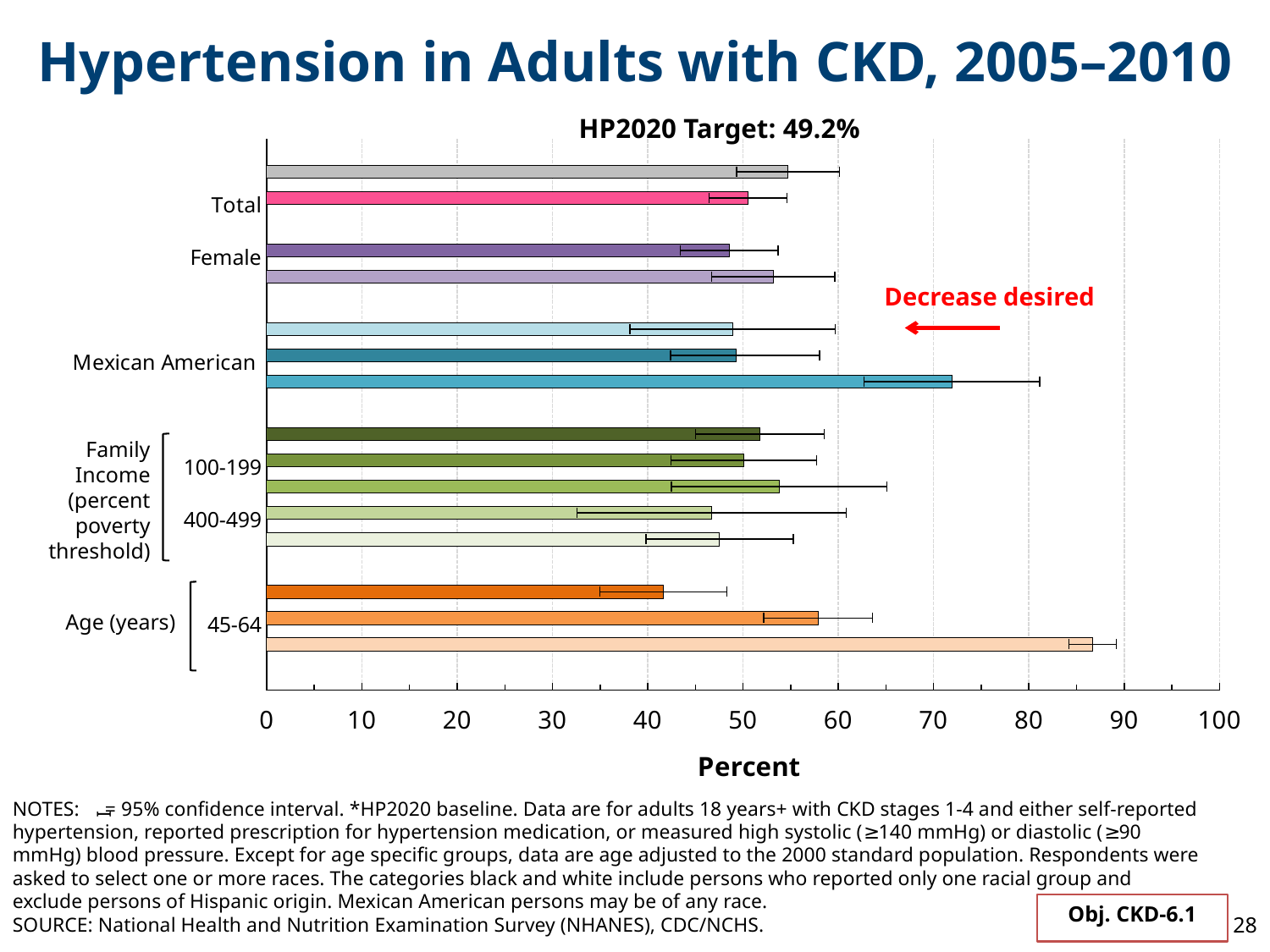
Is the value for Mexican American greater or less than 60? less Which is larger, the value for the 45-64 age group or the value for the 400-499 family income group? 45-64 What kind of chart is shown on the slide? bar chart Is the value for Female greater or less than 60? less Is the value for the 45-64 age group greater or less than 50? greater What is the title of the horizontal axis? Percent Which is larger, the value for Mexican American or the value for the 45-64 age group? 45-64 What is the HP2020 Target value shown above the chart? 49.2%